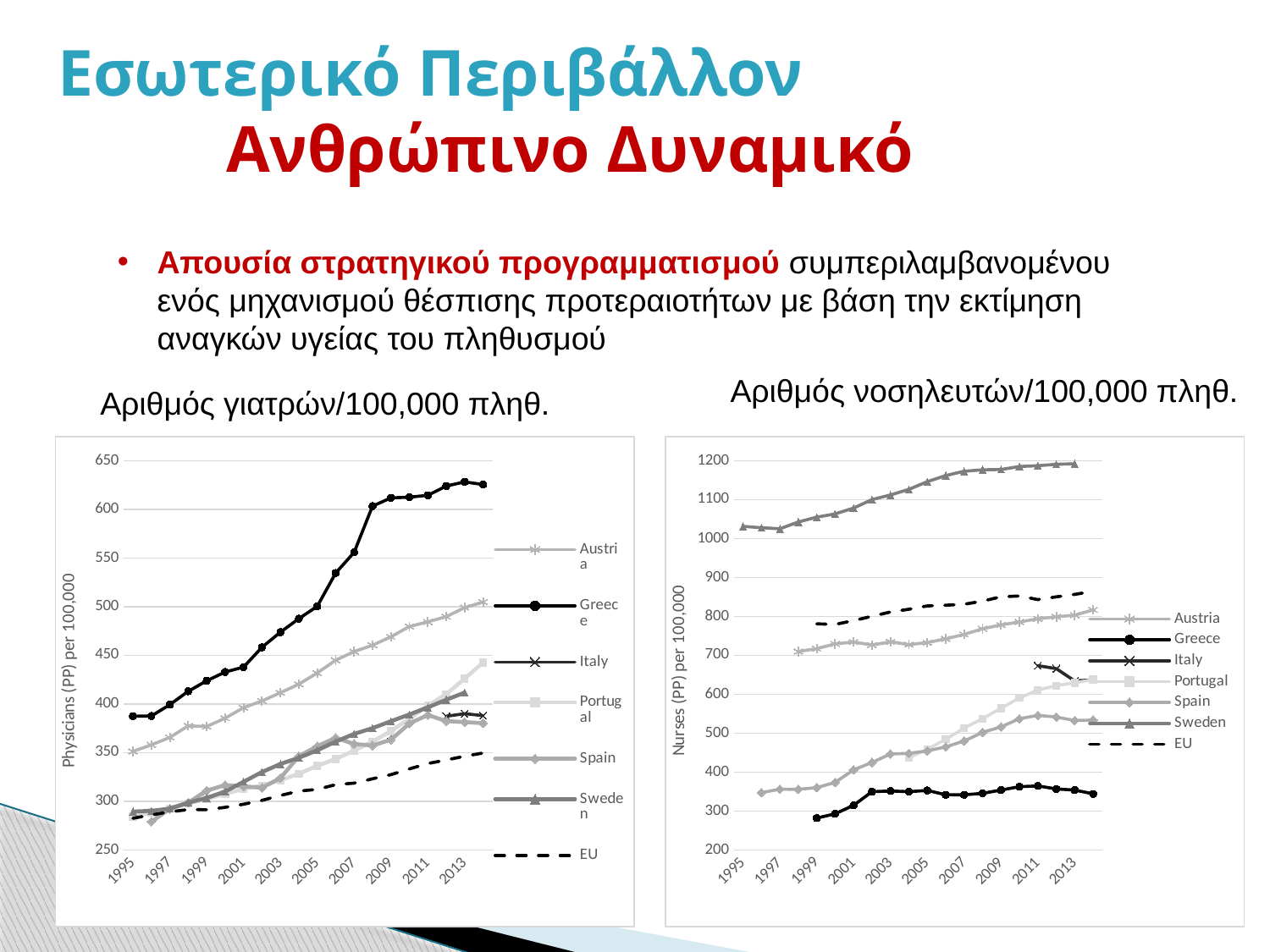
In the right chart (nurses per 100,000), is the value for Greece in 2013 greater or less than 400? less In the right chart (nurses per 100,000), which country has the highest values? Sweden In the right chart (nurses per 100,000), is the value for Sweden in 2013 greater or less than 1100? greater In the right chart (nurses per 100,000), which country has the lowest value in 2013? Greece In the right chart (nurses per 100,000), which is larger in 2013, Austria or Portugal? Austria In the left chart (physicians per 100,000), which country has the highest value in 2013? Greece In the left chart (physicians per 100,000), is the value for Greece in 2013 greater or less than 600? greater How many series does the legend of the right chart (Αριθμός νοσηλευτών/100,000 πληθ.) list? 7 What kind of chart is the left chart (Αριθμός γιατρών/100,000 πληθ.)? line chart In the left chart (physicians per 100,000), which series has the lowest value in 2013? EU In the left chart (physicians per 100,000), does the value for Greece rise or fall from 1995 to 2013? rise